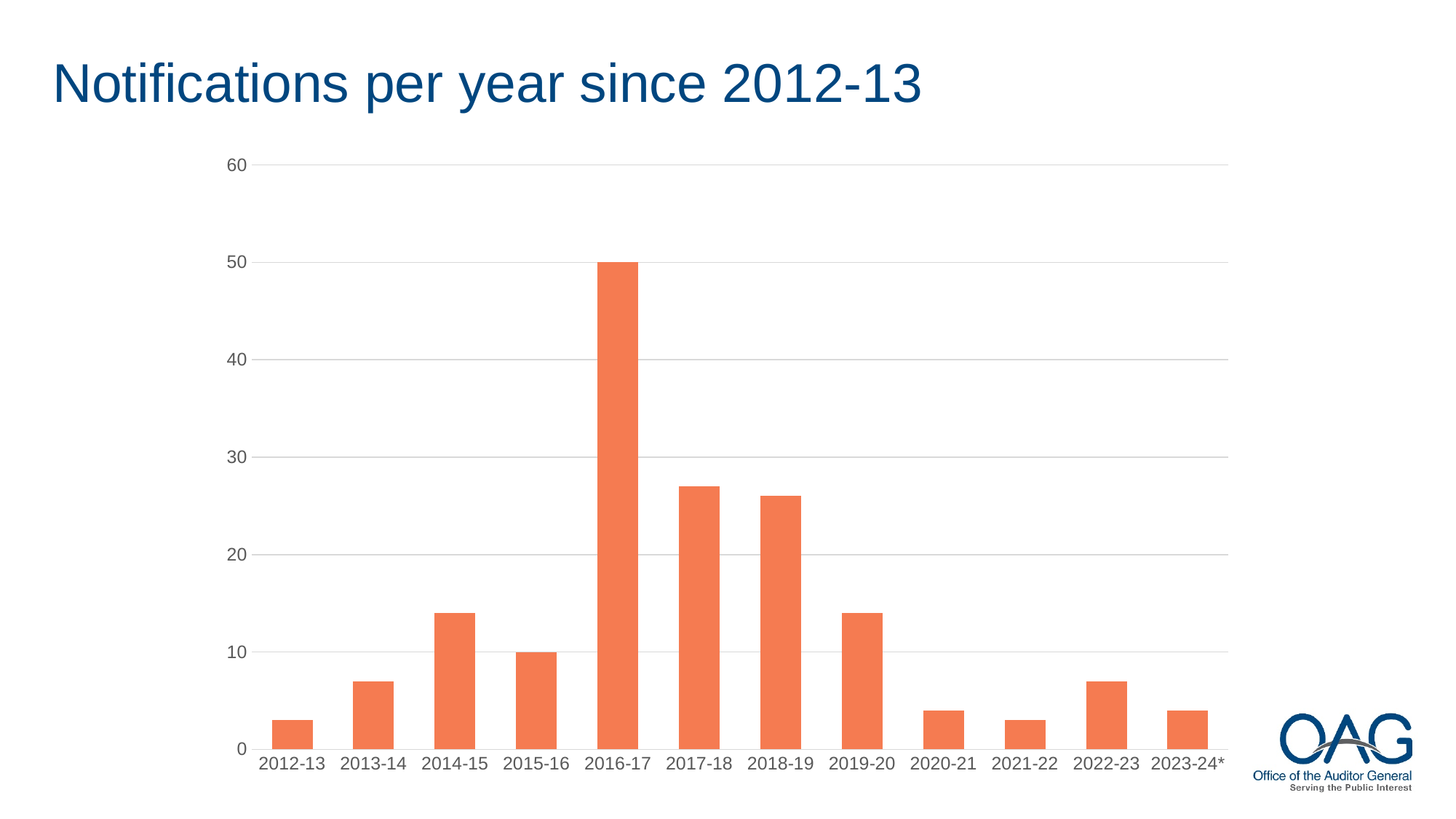
Do the values rise or fall from 2016-17 to 2021-22? fall What is the value for 2015-16? 10 Which is larger, the value for 2014-15 or the value for 2015-16? 2014-15 Is the value for 2020-21 greater or less than 10? less How many years are shown on the x axis of the chart? 12 Is the value for 2014-15 greater or less than 10? greater Is the value for 2017-18 greater or less than 20? greater What is the value for 2016-17? 50 What type of chart is shown on the slide? bar chart Which year has the highest number of notifications? 2016-17 What is the title of the chart? Notifications per year since 2012-13